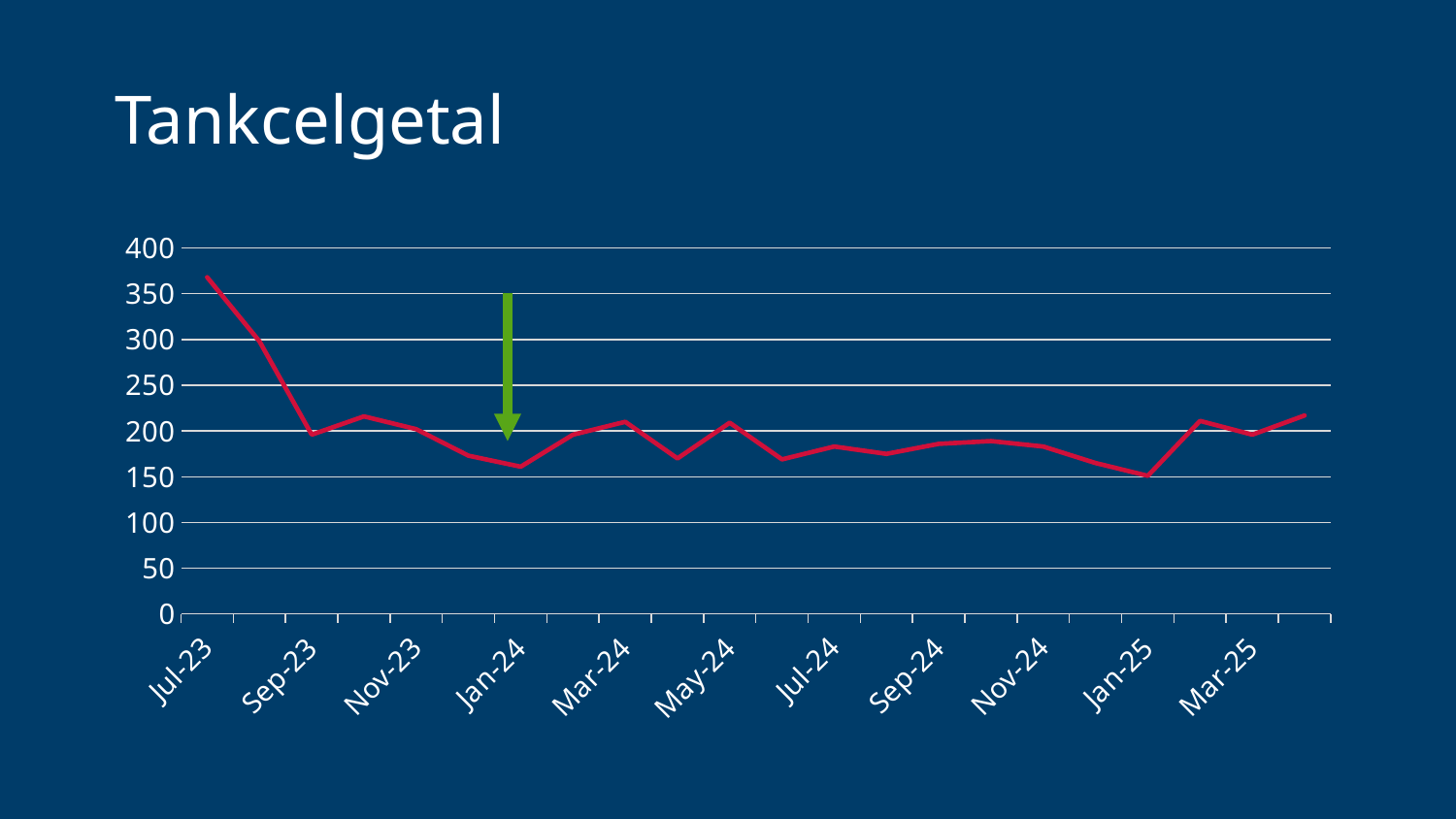
What is the highest value shown on the y axis? 400 Which is larger, the value for Jul-23 or the value for Jan-24? Jul-23 Is the value for Jan-25 greater or less than 200? less What kind of chart is shown on the slide? line chart How many month labels are shown on the x axis? 11 Which month has the highest value on the chart? Jul-23 Does the line rise or fall between Jul-23 and Jan-24? fall Which month does the green arrow point to? Jan-24 What is the title of the chart? Tankcelgetal Is the value for Nov-23 greater or less than 150? greater Is the value for Jul-23 greater or less than 350? greater